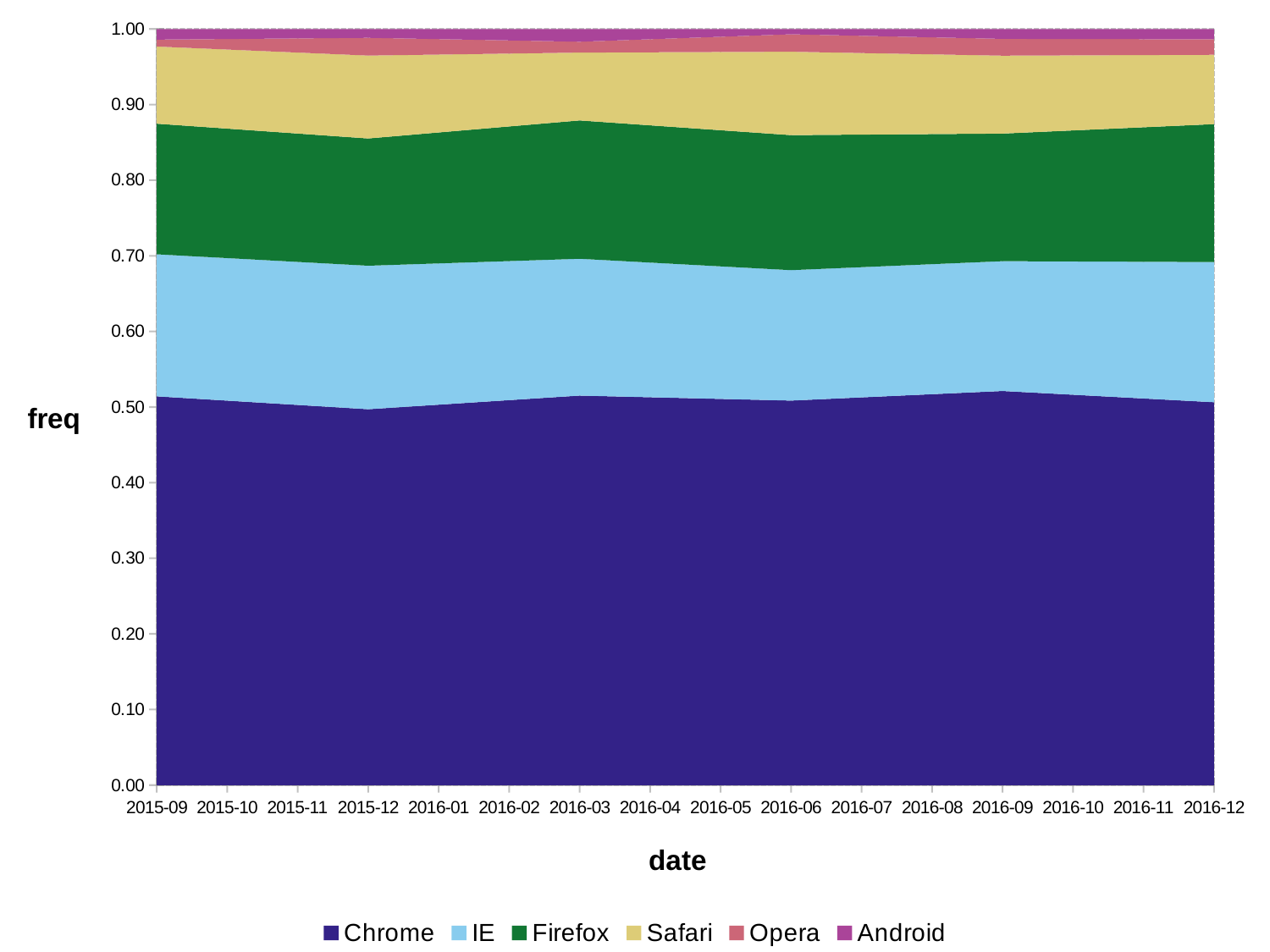
Is the value for Chrome at 2015-09 greater or less than 0.40? greater Which series has the largest share across the dates shown? Chrome Is the value for Chrome at 2016-12 greater or less than 0.60? less Which series has the smallest share across the dates shown? Android How many dates are shown along the x axis? 16 How many series does the legend list? 6 What kind of chart is shown on the slide? Stacked area chart Which series is shown in dark green? Firefox What is the label on the y axis? freq At 2016-06, which is larger, the value for Chrome or the value for IE? Chrome At 2016-01, which is larger, the value for Firefox or the value for Safari? Firefox Is the value for IE at 2016-03 greater or less than 0.30? less